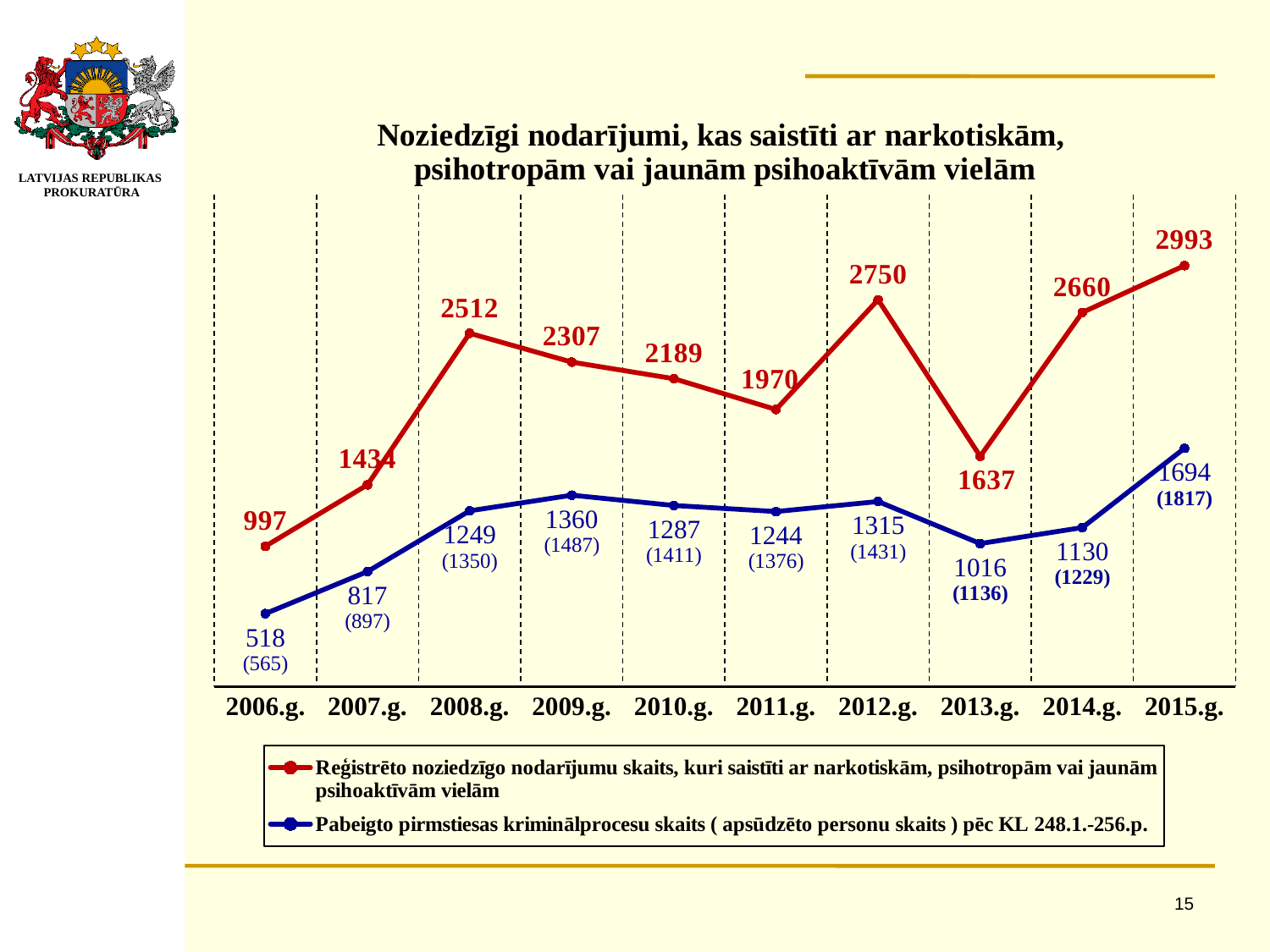
What type of chart is shown on the slide? Line chart In which year does the red series reach its highest value? 2015.g. What is the number of accused persons shown in parentheses for 2015.g.? 1817 What is the difference between the red and blue series values for 2006.g.? 479 What is the value of the blue series (Pabeigto pirmstiesas kriminālprocesu skaits) for 2009.g.? 1360 In which year does the blue series have its lowest value? 2006.g. What is the value of the red series (Reģistrēto noziedzīgo nodarījumu skaits) for 2012.g.? 2750 How many years are plotted along the x axis? 10 What is the difference between the red series values for 2012.g. and 2013.g.? 1113 How many series does the legend list? 2 Which is larger: the red series value for 2008.g. or for 2014.g.? 2014.g. Does the red series rise or fall from 2013.g. to 2015.g.? Rise